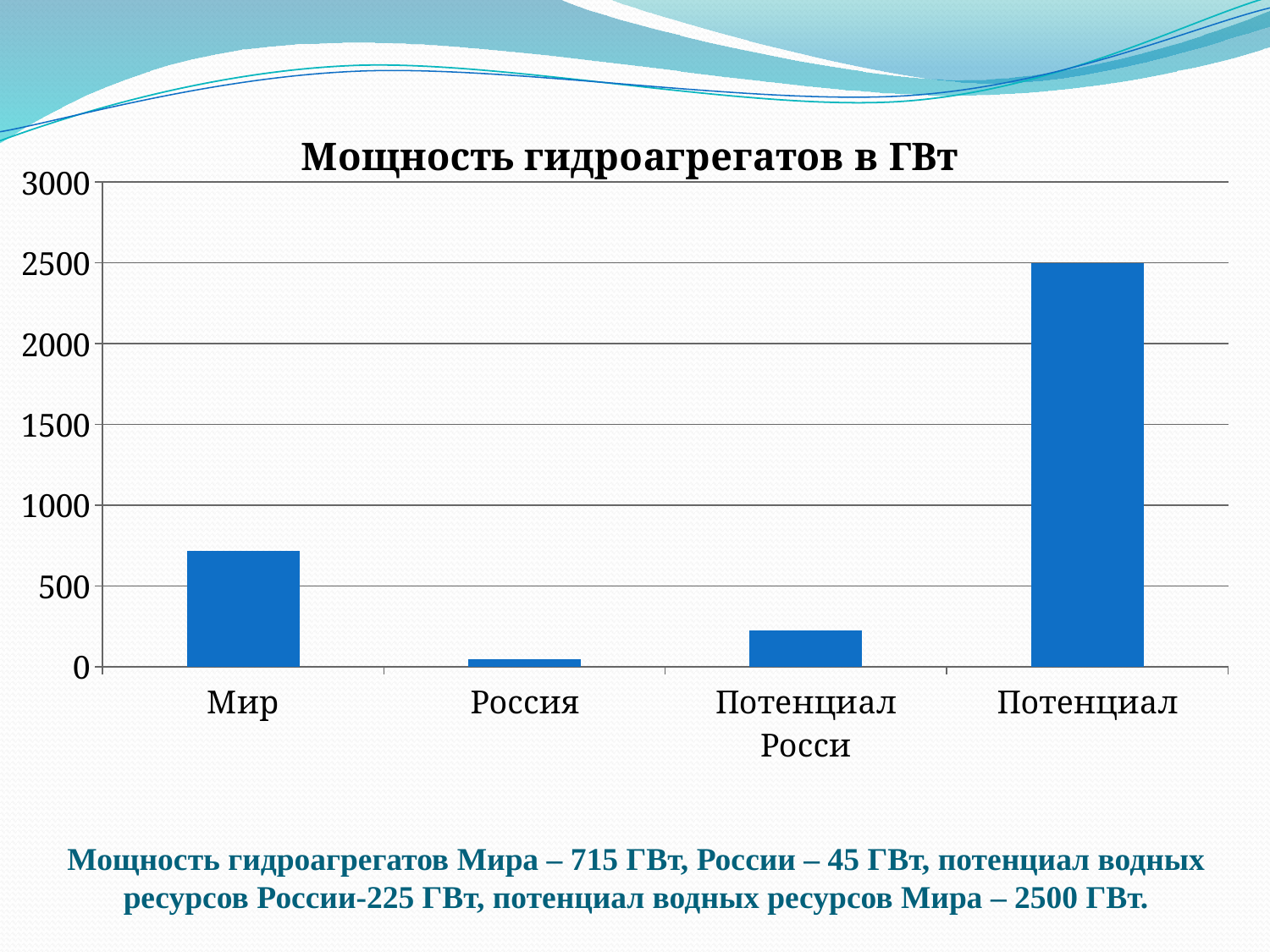
According to the text below the chart, what is the hydro capacity of Russia (Россия) in GW? 45 ГВт What is the title of the chart? Мощность гидроагрегатов в ГВт Which is larger, the value for Россия or the value for Потенциал Росси? Потенциал Росси How many categories are shown on the x axis of the chart? 4 Is the value for Потенциал Росси greater or less than 500? less Which category has the highest bar in the chart? Потенциал Which category has the lowest bar in the chart? Россия Is the value for Мир greater or less than 1000? less What is the value for Потенциал in the chart? 2500 What kind of chart is shown on the slide? bar chart Which is larger, the value for Мир or the value for Потенциал Росси? Мир Is the value for Мир greater or less than 500? greater